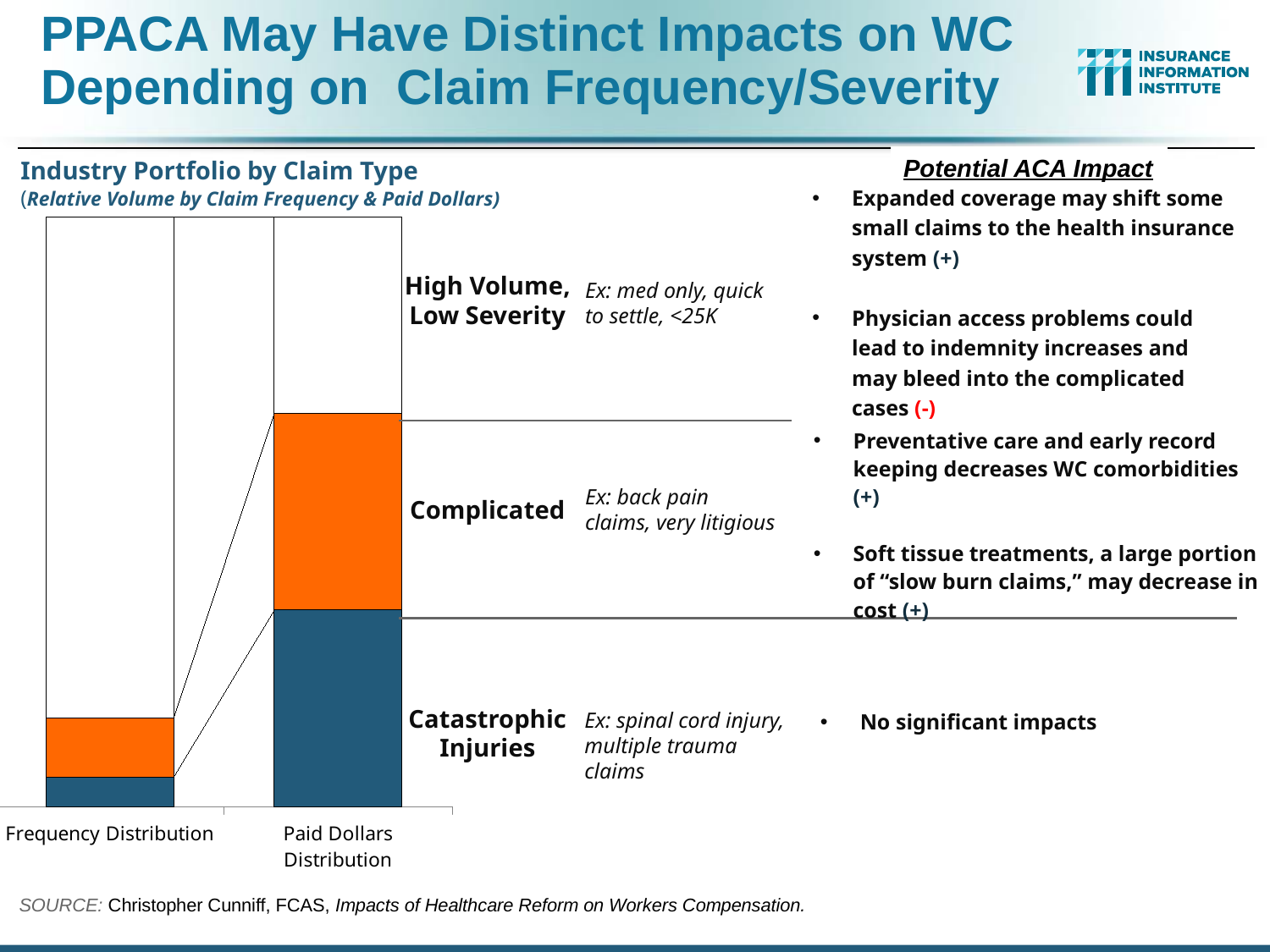
In the Frequency Distribution bar, which claim type takes up the smallest portion? Catastrophic Injuries In the Frequency Distribution bar, which claim type takes up the largest portion? High Volume, Low Severity Which bar has the larger High Volume, Low Severity segment, Frequency Distribution or Paid Dollars Distribution? Frequency Distribution Which bar has the larger Complicated segment, Frequency Distribution or Paid Dollars Distribution? Paid Dollars Distribution How many claim-type segments are stacked in each bar? 3 Which bar has the larger Catastrophic Injuries segment, Frequency Distribution or Paid Dollars Distribution? Paid Dollars Distribution What colour is used for the Complicated claim segment in the chart? Orange How many bars (distributions) are plotted in the chart? 2 What kind of chart is shown on the slide? Stacked bar chart What is the title of the chart? Industry Portfolio by Claim Type